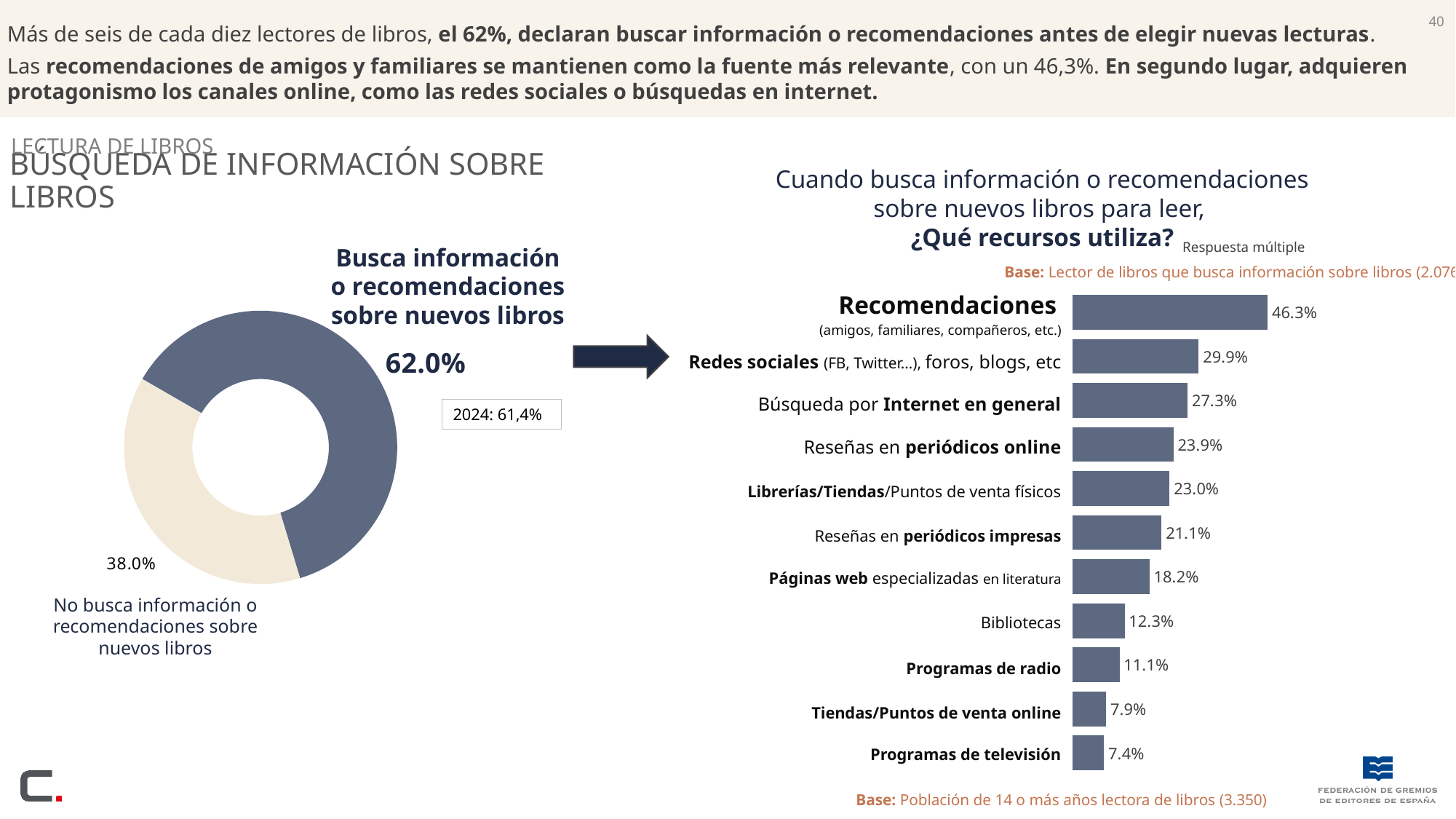
In the bar chart '¿Qué recursos utiliza?', what is the value for Bibliotecas? 12.3% In the donut chart on the left, what is the value for 'No busca información o recomendaciones sobre nuevos libros'? 38.0% In the bar chart '¿Qué recursos utiliza?', what is the difference between Redes sociales (FB, Twitter...), foros, blogs, etc and Búsqueda por Internet en general? 2.6 percentage points In the bar chart '¿Qué recursos utiliza?', what is the value for Programas de radio? 11.1% What kind of chart is the chart on the right of the slide ('¿Qué recursos utiliza?')? Bar chart How many categories are shown in the bar chart '¿Qué recursos utiliza?'? 11 In the bar chart '¿Qué recursos utiliza?', what is the difference between Recomendaciones and Programas de televisión? 38.9 percentage points In the bar chart '¿Qué recursos utiliza?', which category has the highest value? Recomendaciones (amigos, familiares, compañeros, etc.) In the bar chart '¿Qué recursos utiliza?', which is larger: Reseñas en periódicos online or Librerías/Tiendas/Puntos de venta físicos? Reseñas en periódicos online In the donut chart on the left, what share corresponds to 'Busca información o recomendaciones sobre nuevos libros'? 62.0% What kind of chart is the chart on the left of the slide? Donut (pie) chart In the bar chart '¿Qué recursos utiliza?', which category has the lowest value? Programas de televisión